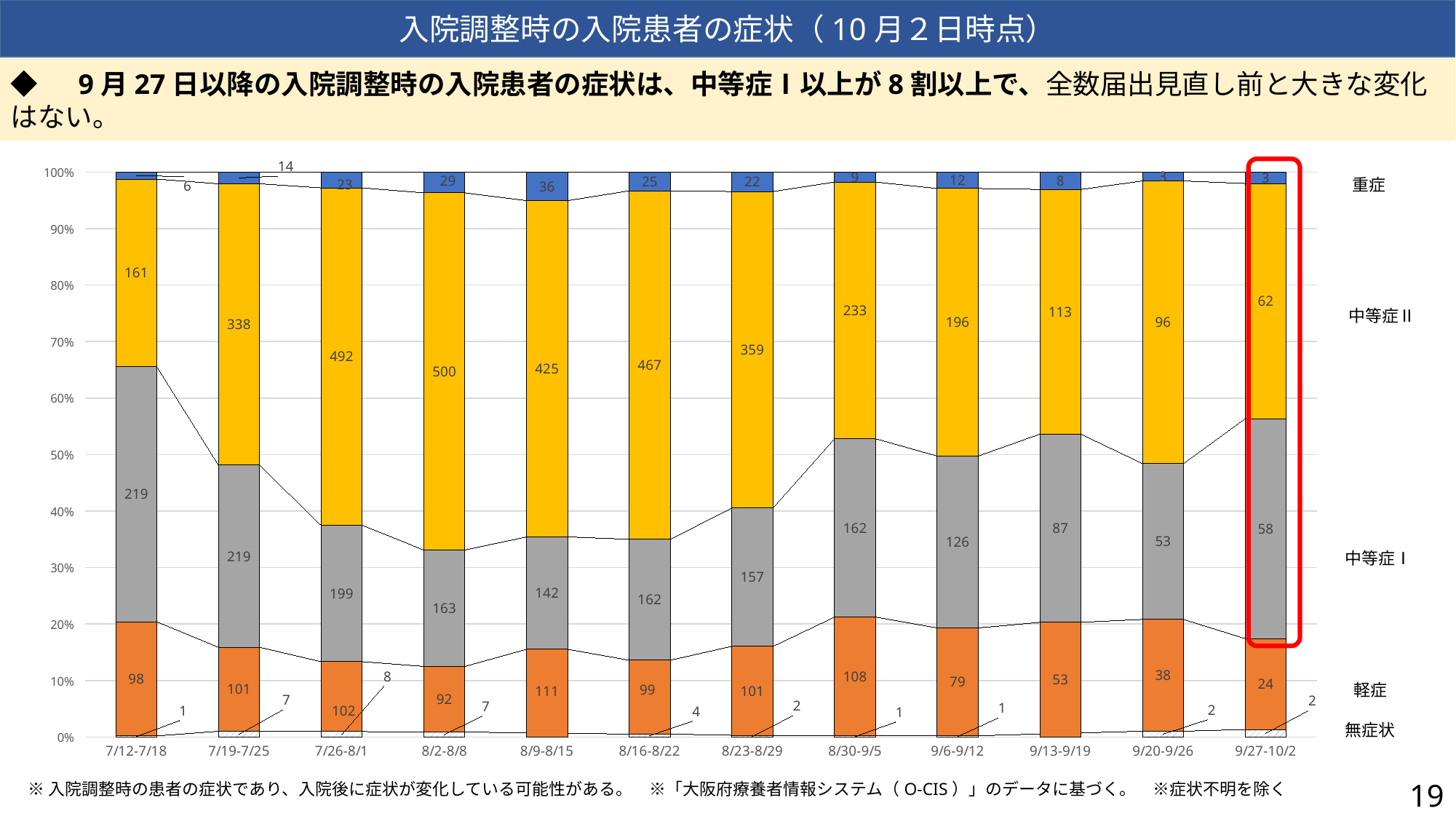
What is the value for 軽症 in the 9/27-10/2 period? 24 What kind of chart is shown on the slide? 100% stacked bar chart In which period is the 中等症Ⅱ value highest? 8/2-8/8 What is the value for 重症 in the 8/9-8/15 period? 36 What is the value for 中等症Ⅰ in the 7/19-7/25 period? 219 How many time periods are shown on the x axis? 12 How many symptom categories (series) are stacked in each bar? 5 What is the total of all segments in the 9/27-10/2 bar? 149 In which period is the 中等症Ⅱ value lowest? 9/27-10/2 What is the difference between the 中等症Ⅱ values for 8/2-8/8 and 7/26-8/1? 8 What is the value for 中等症Ⅱ in the 8/2-8/8 period? 500 In the 9/27-10/2 period, which is larger, 中等症Ⅰ or 中等症Ⅱ? 中等症Ⅱ